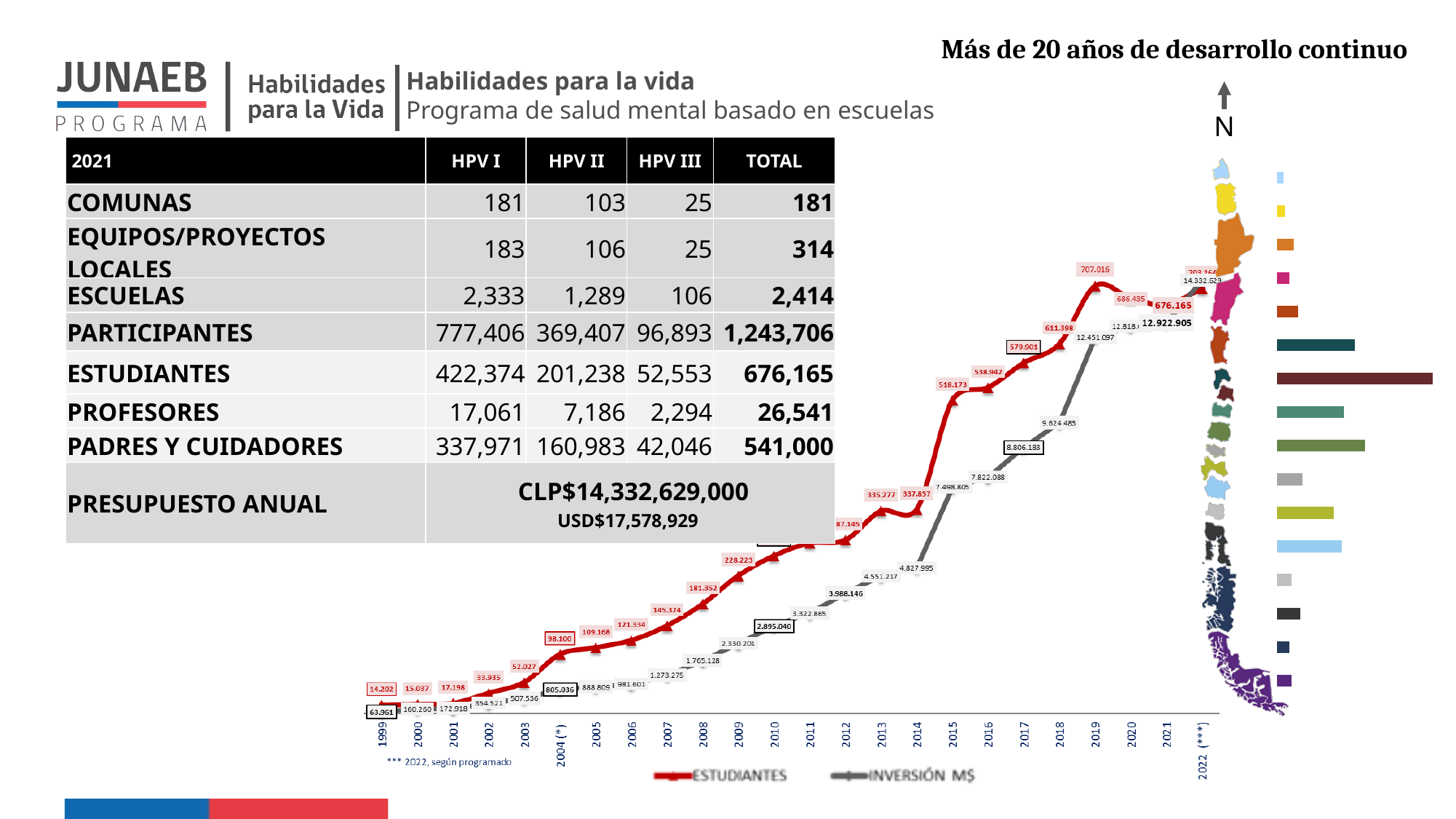
What kind of chart is shown at the bottom of the slide? line chart What is the difference between the ESTUDIANTES values for 2019 and 2021? 30.851 What is the ESTUDIANTES value for 1999 in the line chart? 14.202 What is the ESTUDIANTES value for 2019 in the line chart? 707.016 Which is larger, the ESTUDIANTES value for 2015 or for 2014? 2015 What is the INVERSIÓN M$ value for 2010 in the line chart? 2.895.040 In which year is the INVERSIÓN M$ series at its lowest value? 1999 Does the INVERSIÓN M$ series generally rise or fall from 1999 to 2022? rise What is the INVERSIÓN M$ value for 2022 in the line chart? 14.332.629 What are the two series named in the legend of the line chart? ESTUDIANTES and INVERSIÓN M$ In which year does the ESTUDIANTES series reach its highest value? 2019 How many series does the legend of the line chart list? 2